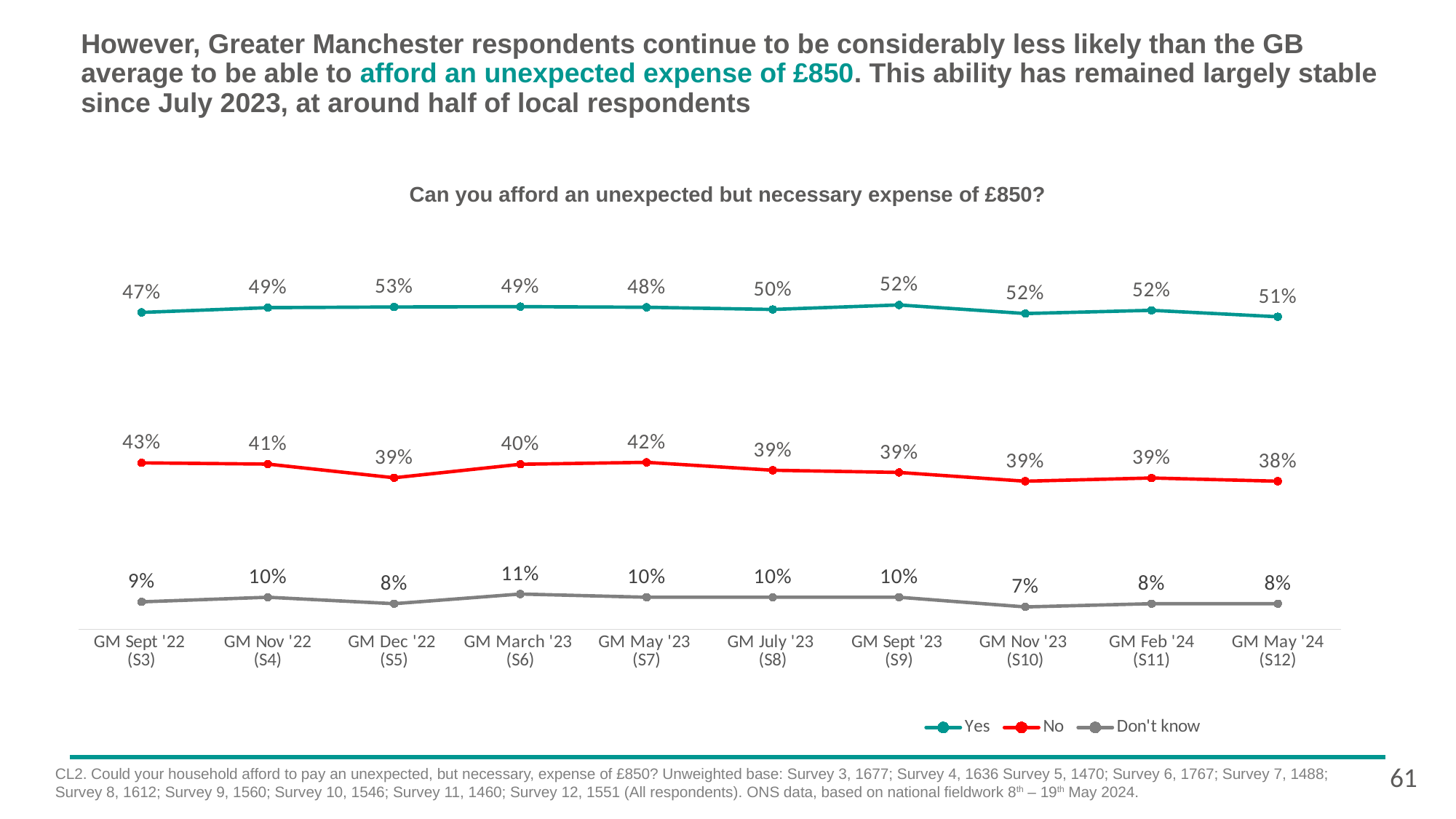
In which survey wave was the Don't know share lowest? GM Nov '23 (S10) How many survey waves are shown on the x axis? 10 What is the difference between the Yes and No shares in GM Sept '22 (S3)? 4 percentage points What percentage of respondents answered Don't know in GM March '23 (S6)? 11% What is the title of the chart? Can you afford an unexpected but necessary expense of £850? What percentage of respondents answered Yes in GM Dec '22 (S5)? 53% How many series does the legend list? 3 What kind of chart is shown on the slide? Line chart What percentage of respondents answered No in GM May '24 (S12)? 38% Which is larger in GM May '23 (S7): the Yes share or the No share? Yes Did the No share rise or fall between GM Sept '22 (S3) and GM May '24 (S12)? Fall In which survey wave was the Yes share highest? GM Dec '22 (S5)